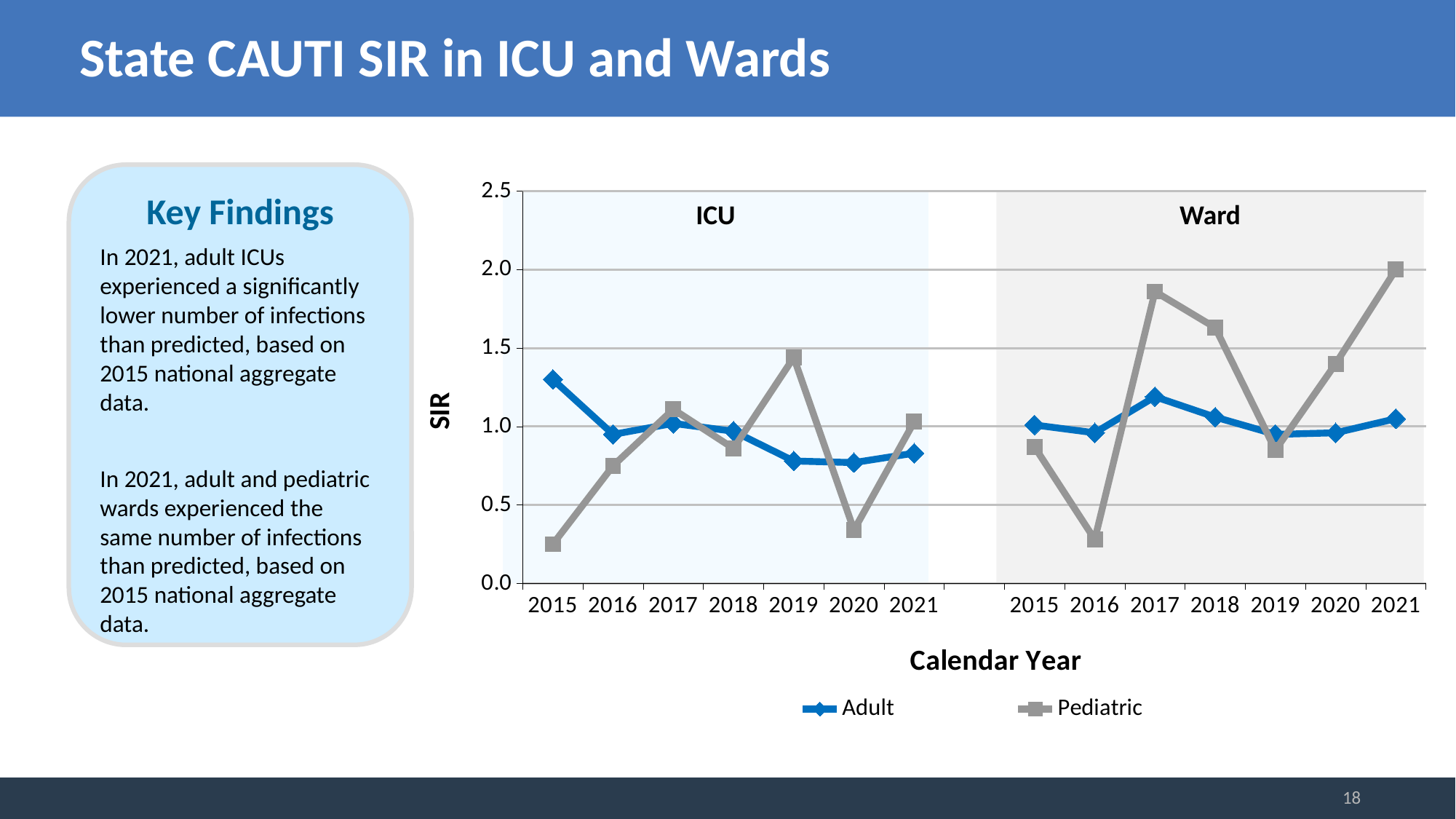
What is the title of the chart's x axis? Calendar Year Does the Adult SIR in the ICU panel rise or fall from 2015 to 2019? fall In the ICU panel for 2019, which series has the higher SIR, Adult or Pediatric? Pediatric In the Ward panel, which year has the lowest Pediatric SIR? 2016 How many series does the chart legend list? 2 In the ICU panel, is the Pediatric SIR for 2015 greater or less than 0.5? less In the ICU panel, is the Pediatric SIR for 2019 greater or less than 1.0? greater In the Ward panel, is the Pediatric SIR for 2017 greater or less than 1.5? greater In the Ward panel, which year has the highest Pediatric SIR? 2021 How many calendar years are plotted in the ICU panel of the chart? 7 What kind of chart is shown on the slide? line chart